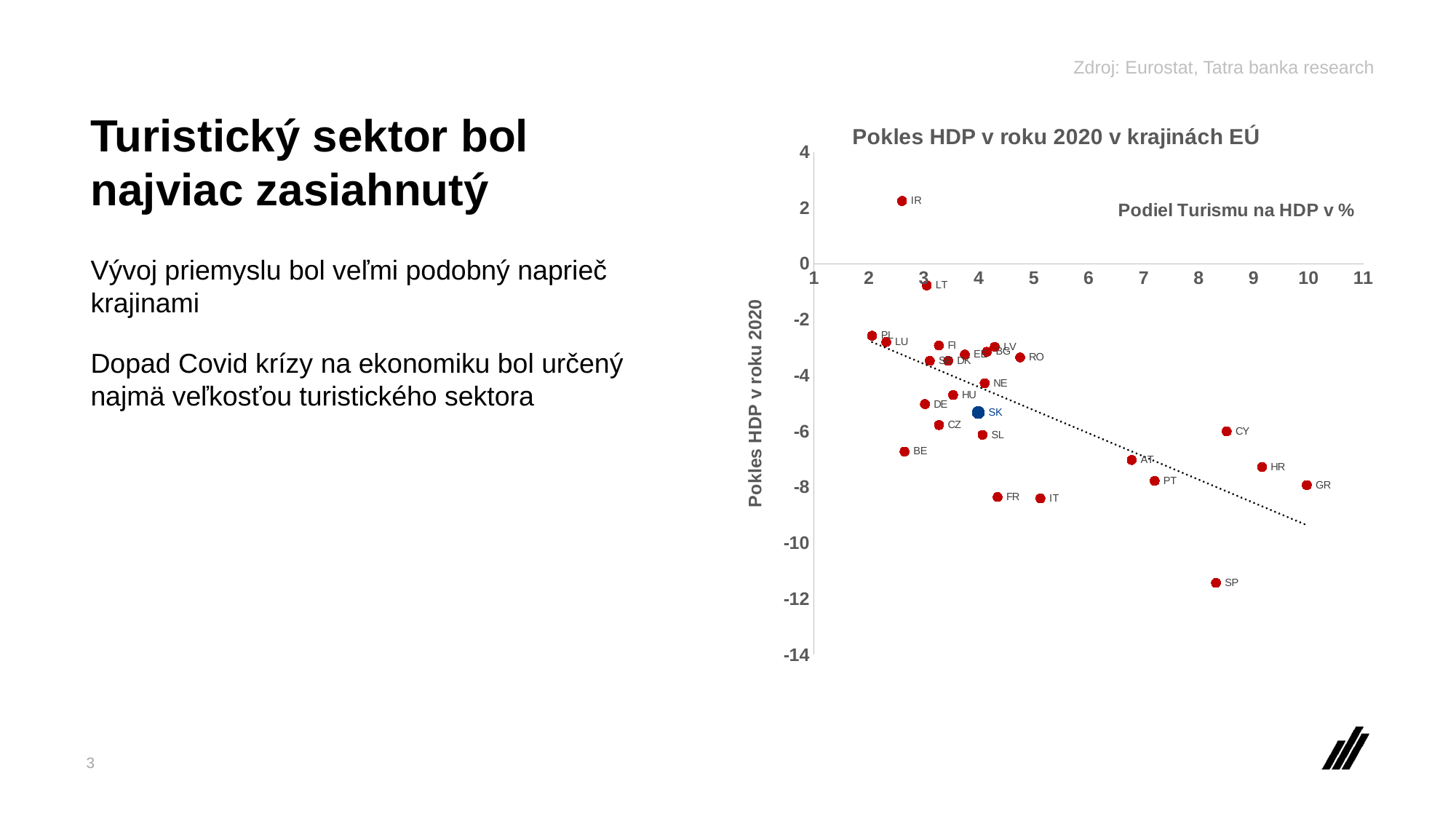
What is the label of the vertical axis of the chart? Pokles HDP v roku 2020 What kind of chart is shown on the slide? scatter chart Is the vertical-axis value for SK greater or less than -6? greater Which country has the highest value on the vertical axis (Pokles HDP v roku 2020)? IR Which country has the highest share of tourism in GDP (furthest right on the horizontal axis)? GR Do the vertical-axis values generally rise or fall as the share of tourism in GDP increases along the horizontal axis? fall What is the title of the chart? Pokles HDP v roku 2020 v krajinách EÚ Is the horizontal-axis value (Podiel Turismu na HDP v %) for GR greater or less than 9? greater Is the vertical-axis value for SP greater or less than -10? less Which country has a higher vertical-axis value, CY or SP? CY Which country has the lowest value on the vertical axis (Pokles HDP v roku 2020)? SP